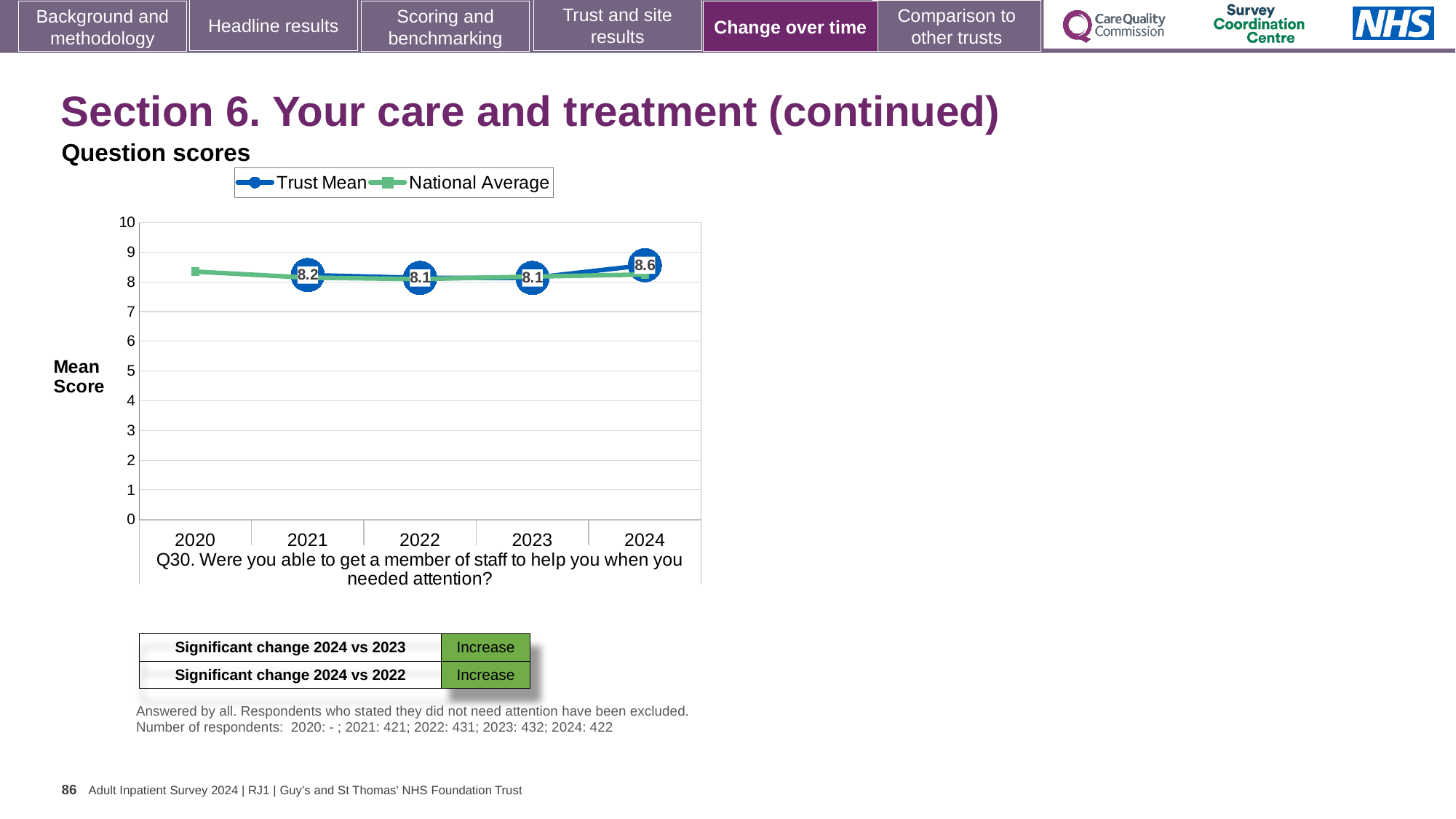
In which year is the Trust Mean score highest? 2024 What is the Trust Mean score for 2022? 8.1 Does the Trust Mean score rise or fall from 2023 to 2024? Rise What is the Trust Mean score for 2021? 8.2 Which is larger, the Trust Mean score for 2024 or for 2021? 2024 What is the Trust Mean score for 2024? 8.6 How many series does the legend list? 2 Is the National Average value for 2020 greater or less than 8? greater How many years are shown on the x axis? 5 What is the label on the y axis of the chart? Mean Score What kind of chart is shown on the slide? Line chart What is the difference between the Trust Mean scores for 2024 and 2023? 0.5